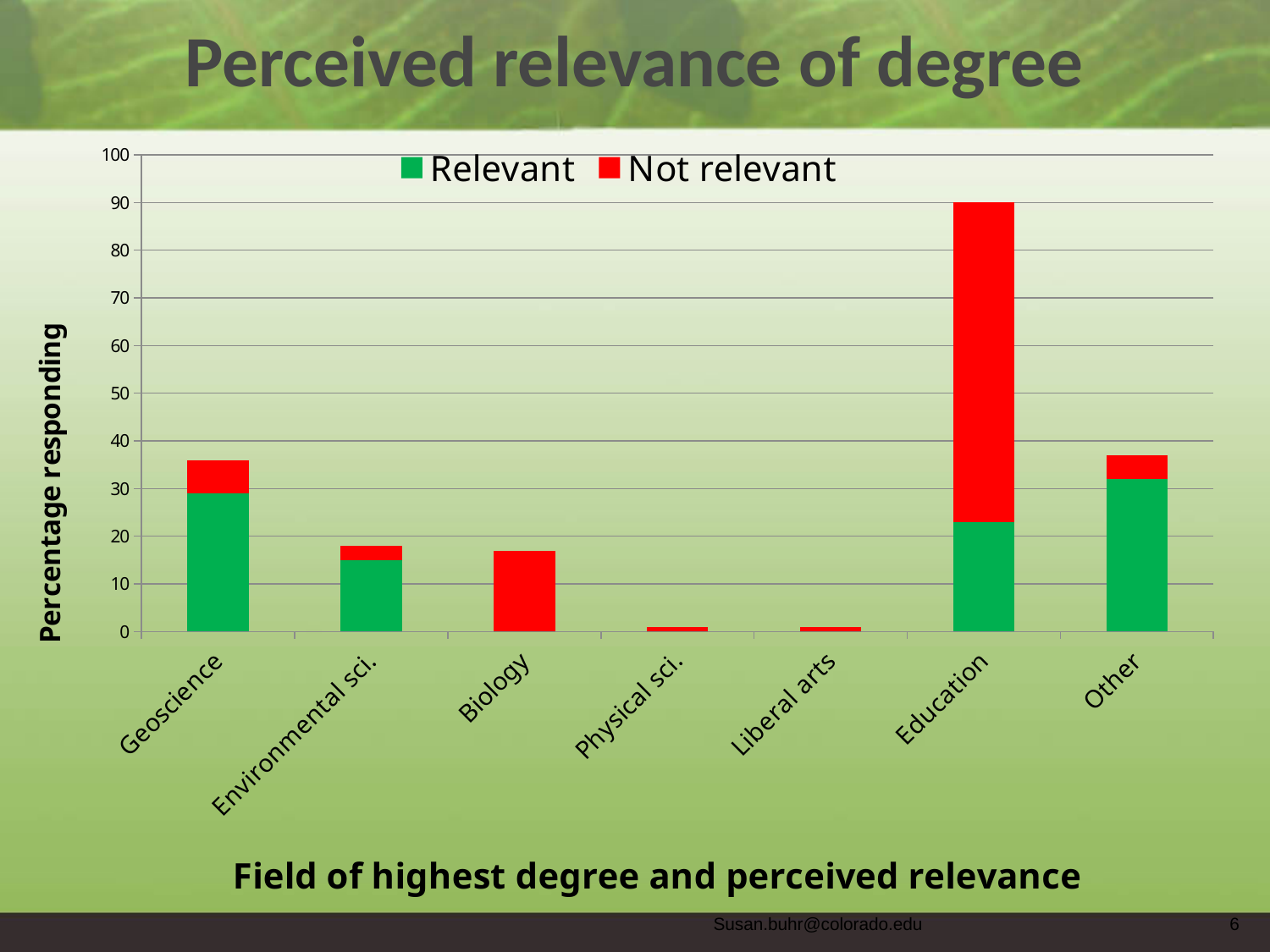
What kind of chart is shown on the slide? Stacked bar chart Is the total value for Geoscience greater or less than 40? less Is the Relevant value for Other greater or less than 30? greater Which field has the larger total bar, Education or Geoscience? Education What is the label on the y axis? Percentage responding Which field has the tallest stacked bar? Education What is the title of the slide's chart? Perceived relevance of degree How many degree fields are shown on the x axis? 7 How many series does the legend list? 2 Is the total value for Education greater or less than 80? greater Which field has the larger total bar, Other or Environmental sci.? Other